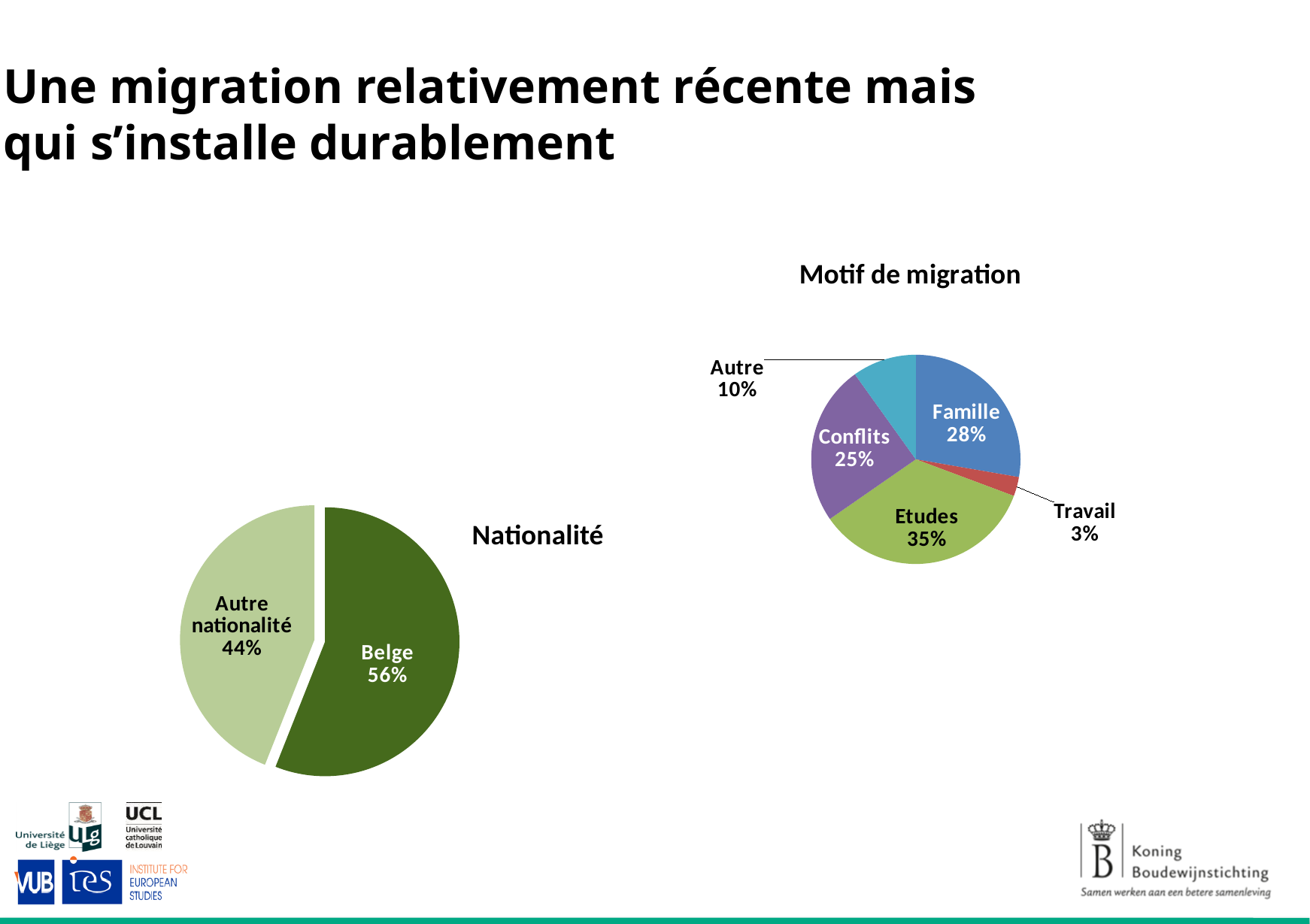
In the 'Motif de migration' chart, what is the share for Travail? 3% In the 'Motif de migration' chart, what is the difference between the Famille and Autre shares? 18% In the 'Nationalité' chart, which slice is larger, Belge or Autre nationalité? Belge In the 'Motif de migration' chart, which category has the largest share? Etudes In the 'Nationalité' chart, what is the share for Autre nationalité? 44% In the 'Nationalité' chart, what is the difference between the Belge and Autre nationalité shares? 12% What type of chart is the 'Nationalité' chart? Pie chart In the 'Nationalité' chart, what is the share for Belge? 56% In the 'Motif de migration' chart, how many categories are shown? 5 In the 'Motif de migration' chart, which category has the smallest share? Travail In the 'Motif de migration' chart, what is the share for Conflits? 25% In the 'Motif de migration' chart, what is the share for Etudes? 35%